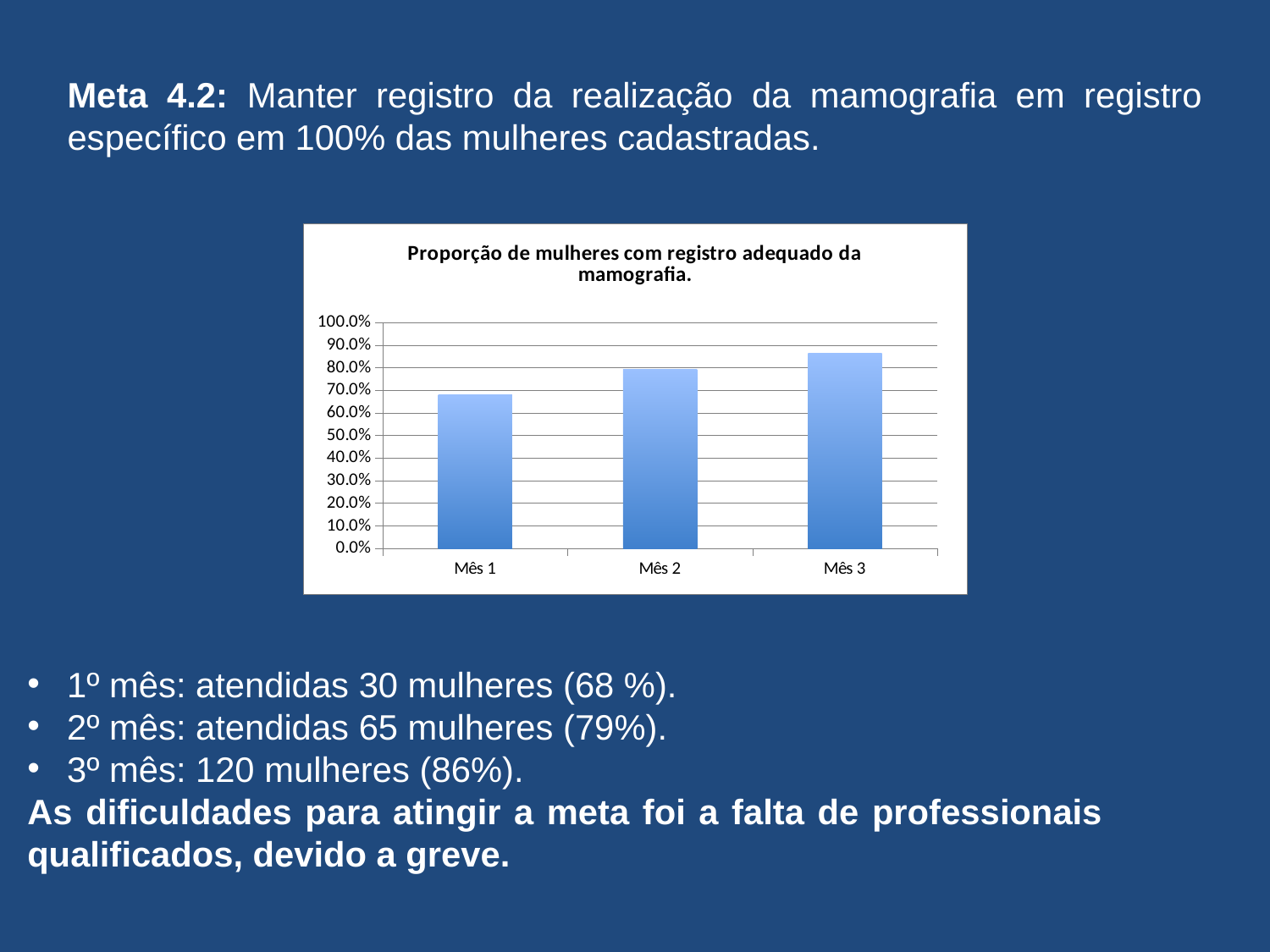
Which is larger, the value for Mês 2 or the value for Mês 1? Mês 2 Is the value for Mês 1 greater or less than 60.0%? greater Which month has the highest bar in the chart? Mês 3 Is the value for Mês 1 greater or less than 70.0%? less What kind of chart is shown on the slide? bar chart What is the title of the chart? Proporção de mulheres com registro adequado da mamografia. Is the value for Mês 2 greater or less than 70.0%? greater Do the values rise or fall from Mês 1 to Mês 3? rise Which month has the lowest bar in the chart? Mês 1 How many categories are shown on the x axis of the chart? 3